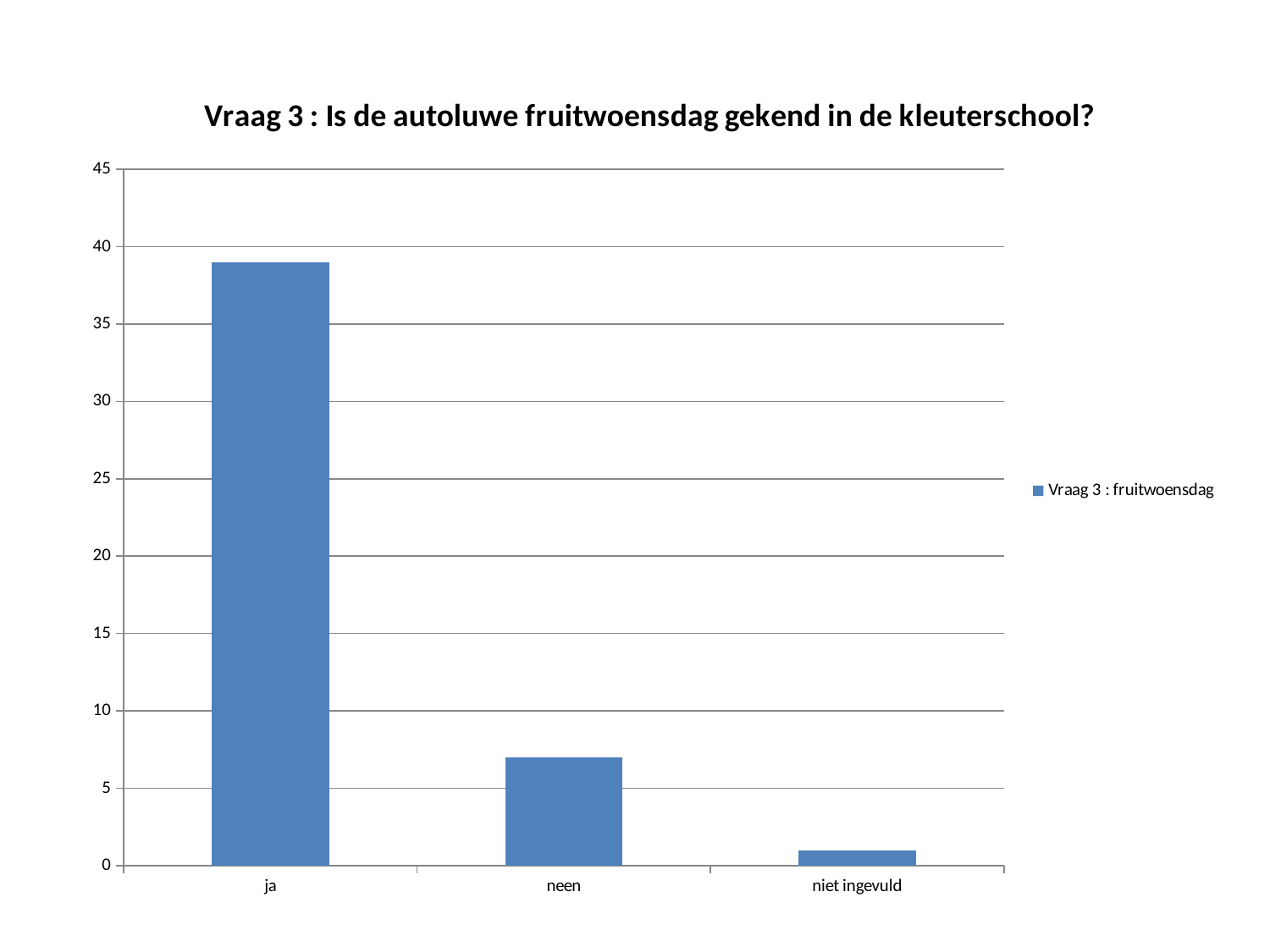
Which is larger, the value for neen or the value for niet ingevuld? neen What kind of chart is shown on the slide? bar chart Which category has the lowest value? niet ingevuld Is the value for ja greater or less than 35? greater Is the value for ja greater or less than 40? less What is the title of the chart? Vraag 3 : Is de autoluwe fruitwoensdag gekend in de kleuterschool? Is the value for niet ingevuld greater or less than 5? less How many categories are shown on the x axis? 3 Which category has the highest value? ja How many series does the legend list? 1 What is the name of the series in the legend? Vraag 3 : fruitwoensdag